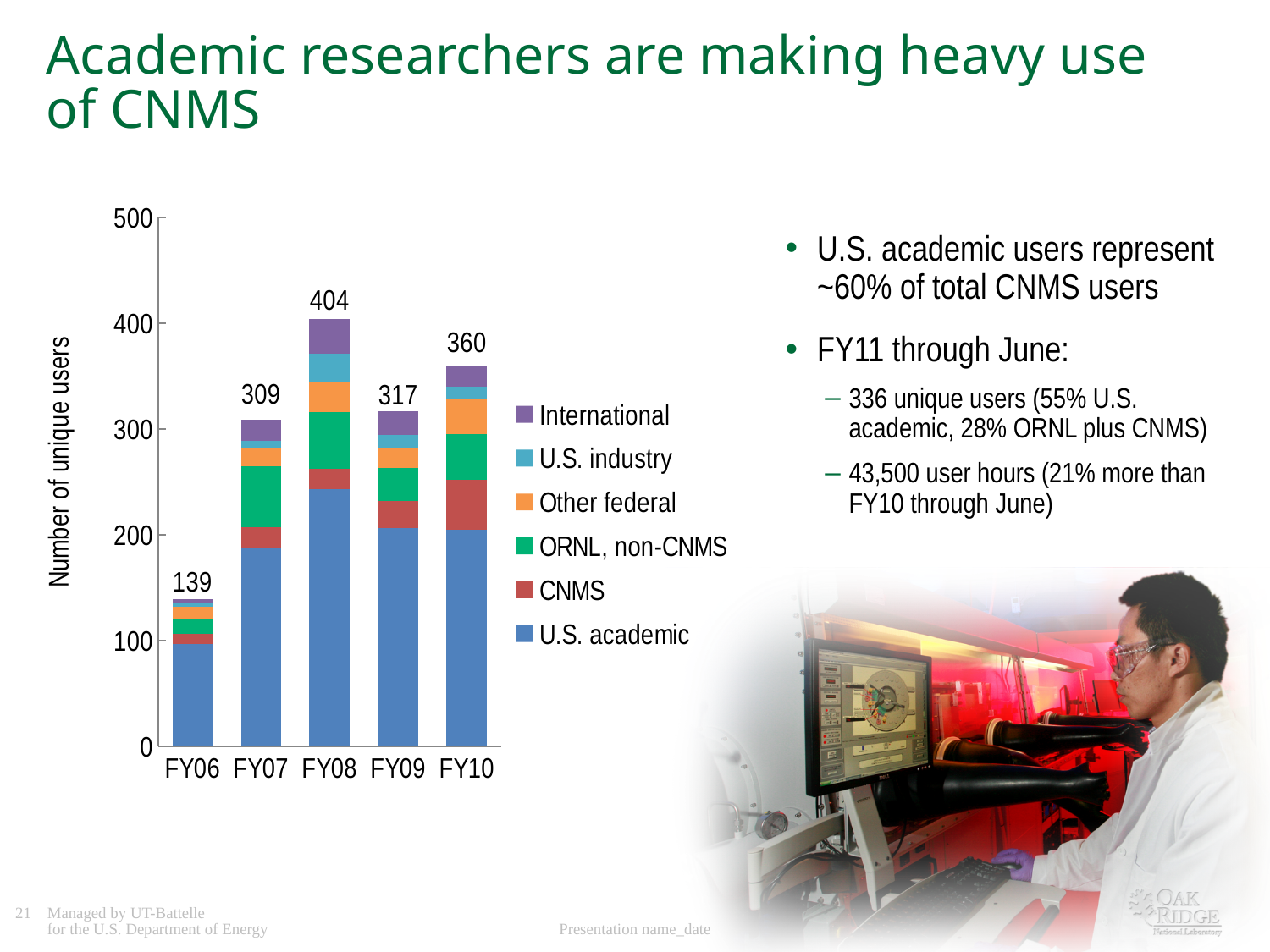
Which fiscal year has the lowest total number of unique users? FY06 Which fiscal year has the highest total number of unique users? FY08 How many series does the chart legend list? 6 Which fiscal year has a larger total of unique users, FY07 or FY10? FY10 What is the difference between the total unique users in FY08 and FY09? 87 What type of chart is used to show the number of unique users? Stacked bar chart What is the total number of unique users shown for FY08? 404 How many fiscal years are shown on the x axis of the chart? 5 Is the U.S. academic value for FY08 greater or less than 200? greater What is the total number of unique users shown for FY10? 360 What is the total number of unique users shown for FY06? 139